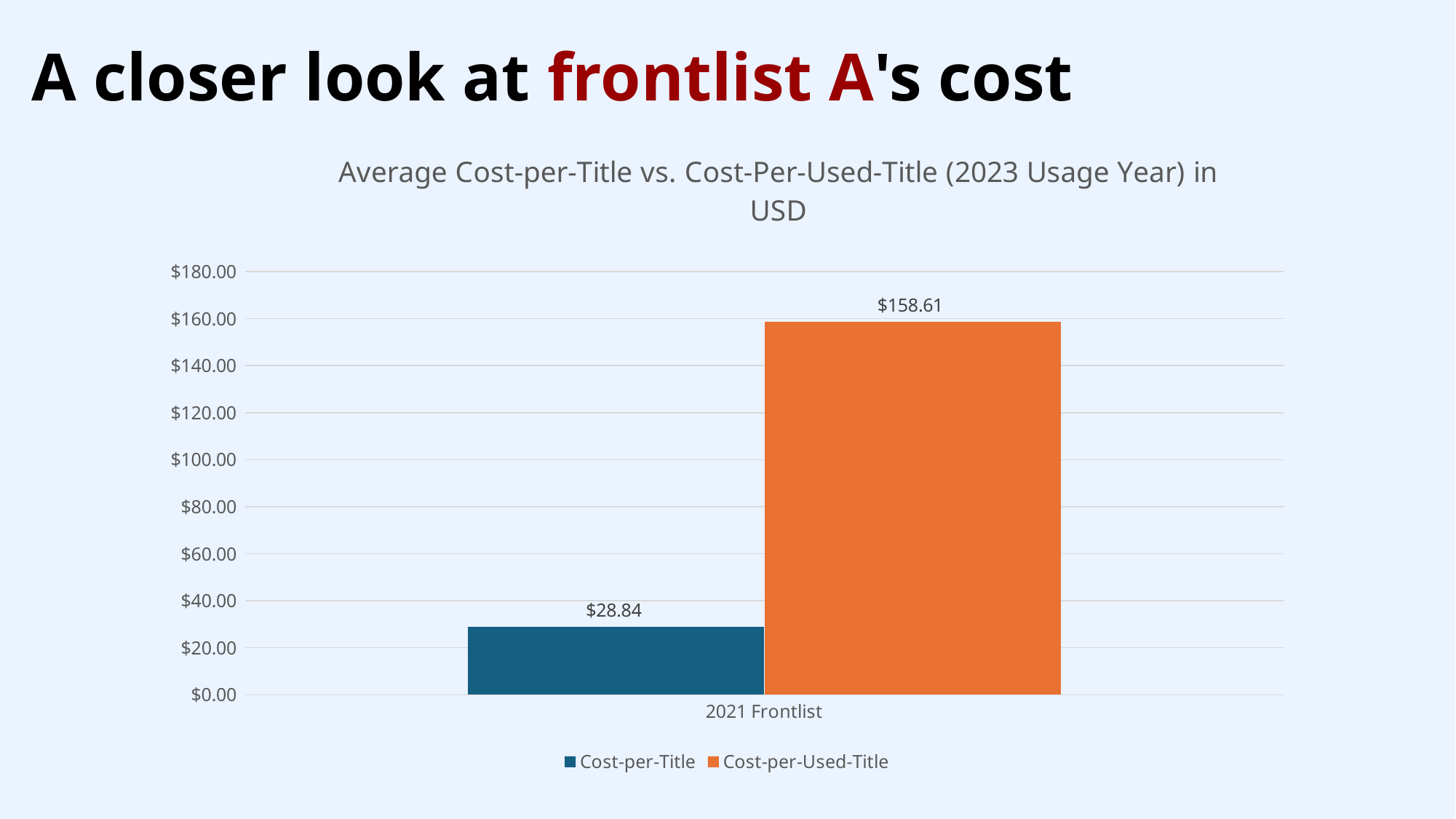
How many categories are shown on the x axis? 1 Is the Cost-per-Used-Title value greater or less than $140.00? greater Which series has the lower value for 2021 Frontlist? Cost-per-Title Is the Cost-per-Used-Title value larger or smaller than the Cost-per-Title value? larger What is the Cost-per-Used-Title value for 2021 Frontlist? $158.61 What is the title of the chart? Average Cost-per-Title vs. Cost-Per-Used-Title (2023 Usage Year) in USD What is the Cost-per-Title value for 2021 Frontlist? $28.84 How many series does the legend list? 2 What kind of chart is shown on the slide? bar chart Which series has the higher value for 2021 Frontlist? Cost-per-Used-Title Is the Cost-per-Title value greater or less than $40.00? less What is the difference between Cost-per-Used-Title and Cost-per-Title for 2021 Frontlist? $129.77